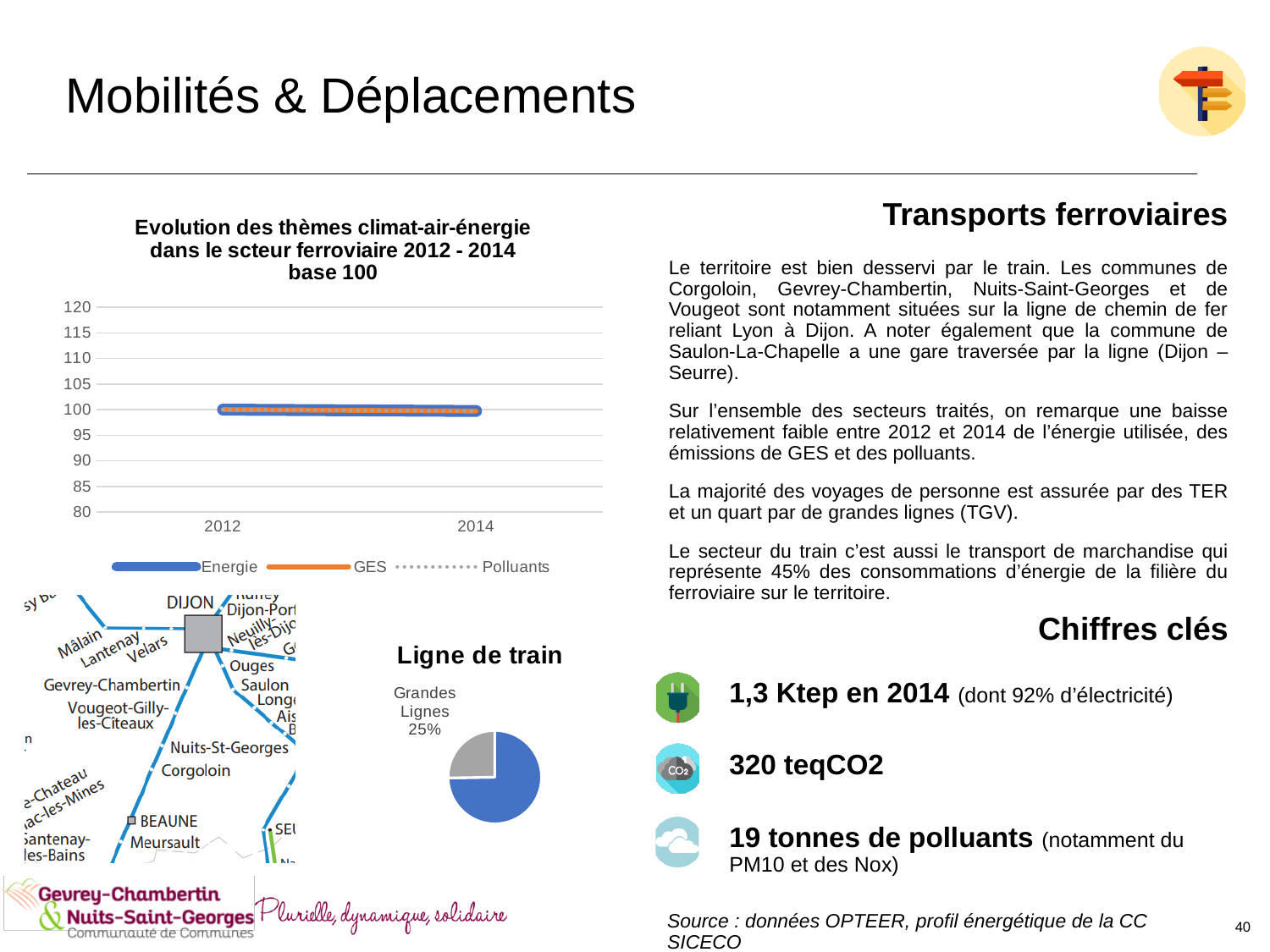
What is the title of the pie chart on the slide? Ligne de train In the 'Ligne de train' pie chart, what share is labelled for Grandes Lignes? 25% How many years are shown on the x axis of the 'Evolution des thèmes climat-air-énergie' line chart? 2 In the 'Evolution des thèmes climat-air-énergie' line chart, is the value for Energie in 2014 greater or less than 110? less What kind of chart is the 'Evolution des thèmes climat-air-énergie dans le secteur ferroviaire 2012 - 2014 base 100' chart? Line chart In the 'Evolution des thèmes climat-air-énergie' line chart, do the series rise, fall or stay roughly flat between 2012 and 2014? Roughly flat How many slices does the 'Ligne de train' pie chart have? 2 What kind of chart is the 'Ligne de train' chart? Pie chart What are the series names in the legend of the 'Evolution des thèmes climat-air-énergie' line chart? Energie, GES, Polluants In the 'Ligne de train' pie chart, is the Grandes Lignes slice larger or smaller than the other slice? smaller How many series does the legend of the 'Evolution des thèmes climat-air-énergie' line chart list? 3 In the 'Evolution des thèmes climat-air-énergie' line chart, is the value for GES in 2012 greater or less than 90? greater